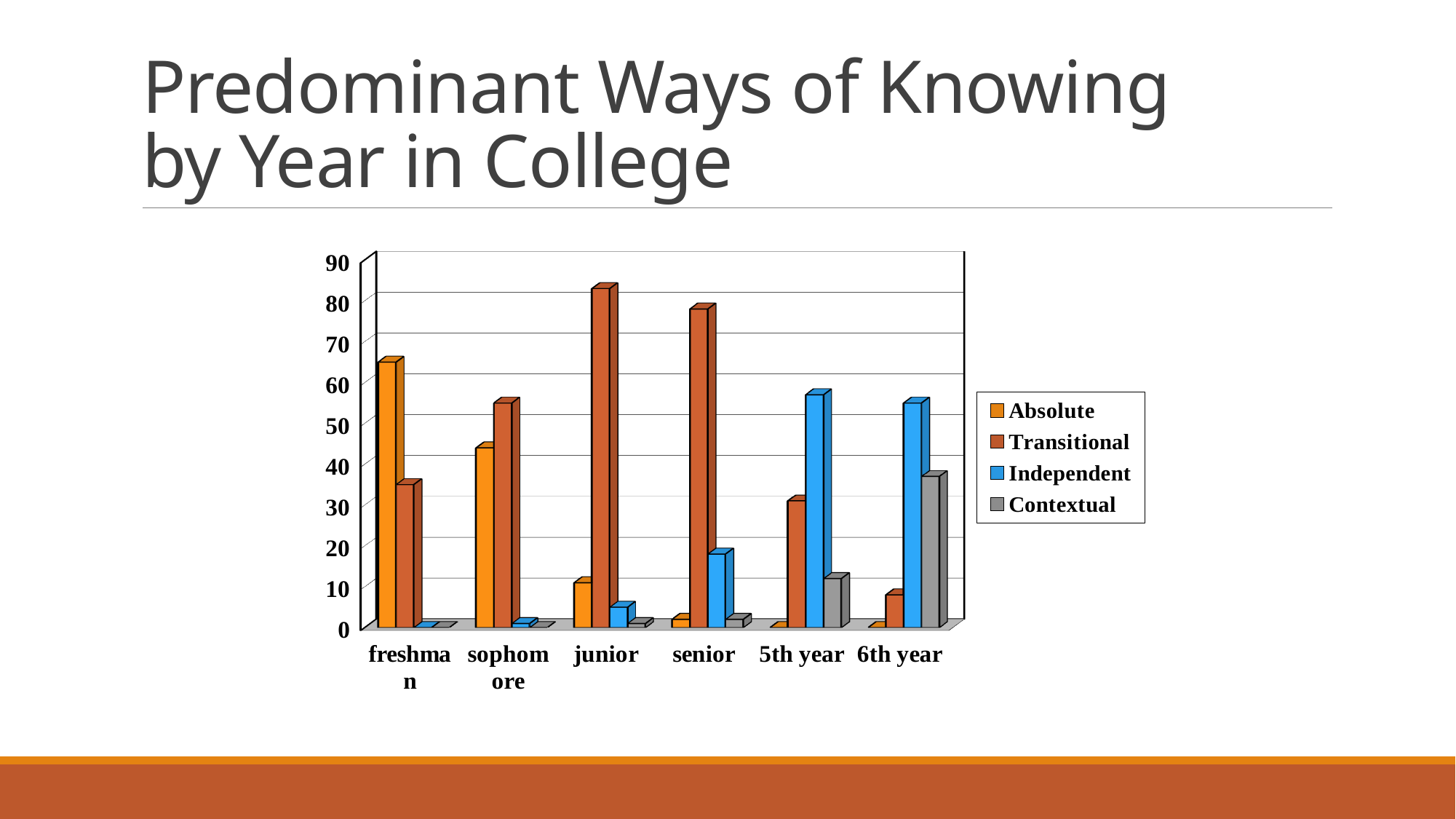
What kind of chart is shown on the slide? bar chart How many series does the legend list? 4 For 5th year, which is larger: Independent or Transitional? Independent Is the Transitional value for junior greater or less than 70? greater Which year has the highest Absolute value? freshman Is the Absolute value for freshman greater or less than 60? greater Do the Absolute values rise or fall from freshman to 6th year? fall For freshman, which is larger: Absolute or Transitional? Absolute Which year has the lowest Transitional value? 6th year Which year has the highest Transitional value? junior Is the Contextual value for 6th year greater or less than 30? greater How many year-in-college categories are shown on the x axis? 6